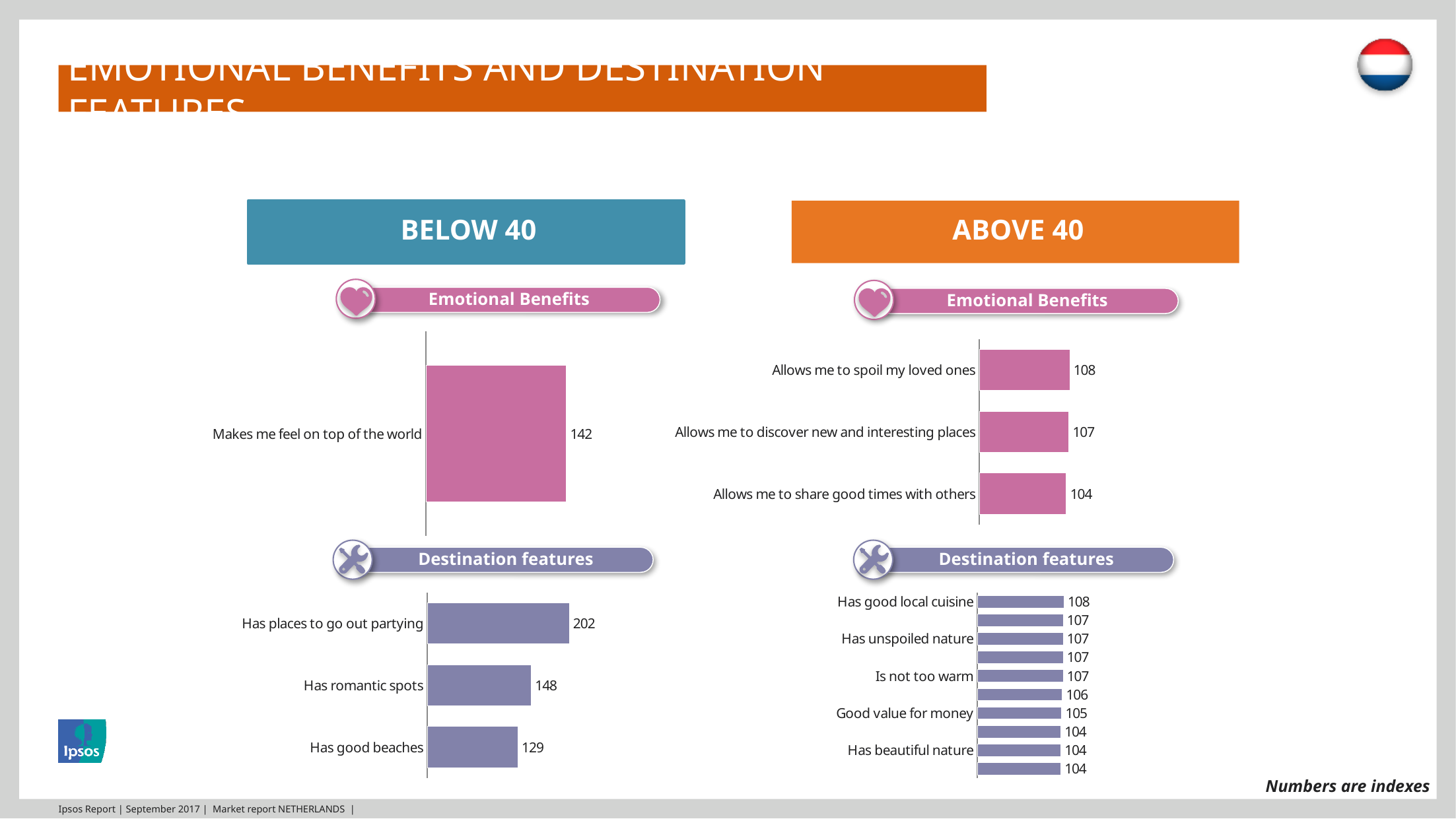
In the Above 40 Emotional Benefits chart, how many categories are plotted? 3 In the Above 40 Destination features chart, how many bars are plotted? 10 In the Above 40 Destination features chart, what is the value for "Good value for money"? 105 In the Above 40 Destination features chart, what is the difference between "Has good local cuisine" and "Has beautiful nature"? 4 In the Below 40 Destination features chart, which category has the highest value? Has places to go out partying In the Above 40 Emotional Benefits chart, what is the value for "Allows me to spoil my loved ones"? 108 In the Above 40 Emotional Benefits chart, which category has the lowest value? Allows me to share good times with others In the Below 40 Destination features chart, which is larger: "Has romantic spots" or "Has good beaches"? Has romantic spots In the Below 40 Destination features chart, what is the difference between "Has places to go out partying" and "Has good beaches"? 73 What kind of chart is the Below 40 Destination features chart? Bar chart In the Below 40 Emotional Benefits chart, what is the value for "Makes me feel on top of the world"? 142 In the Below 40 Destination features chart, what is the value for "Has romantic spots"? 148